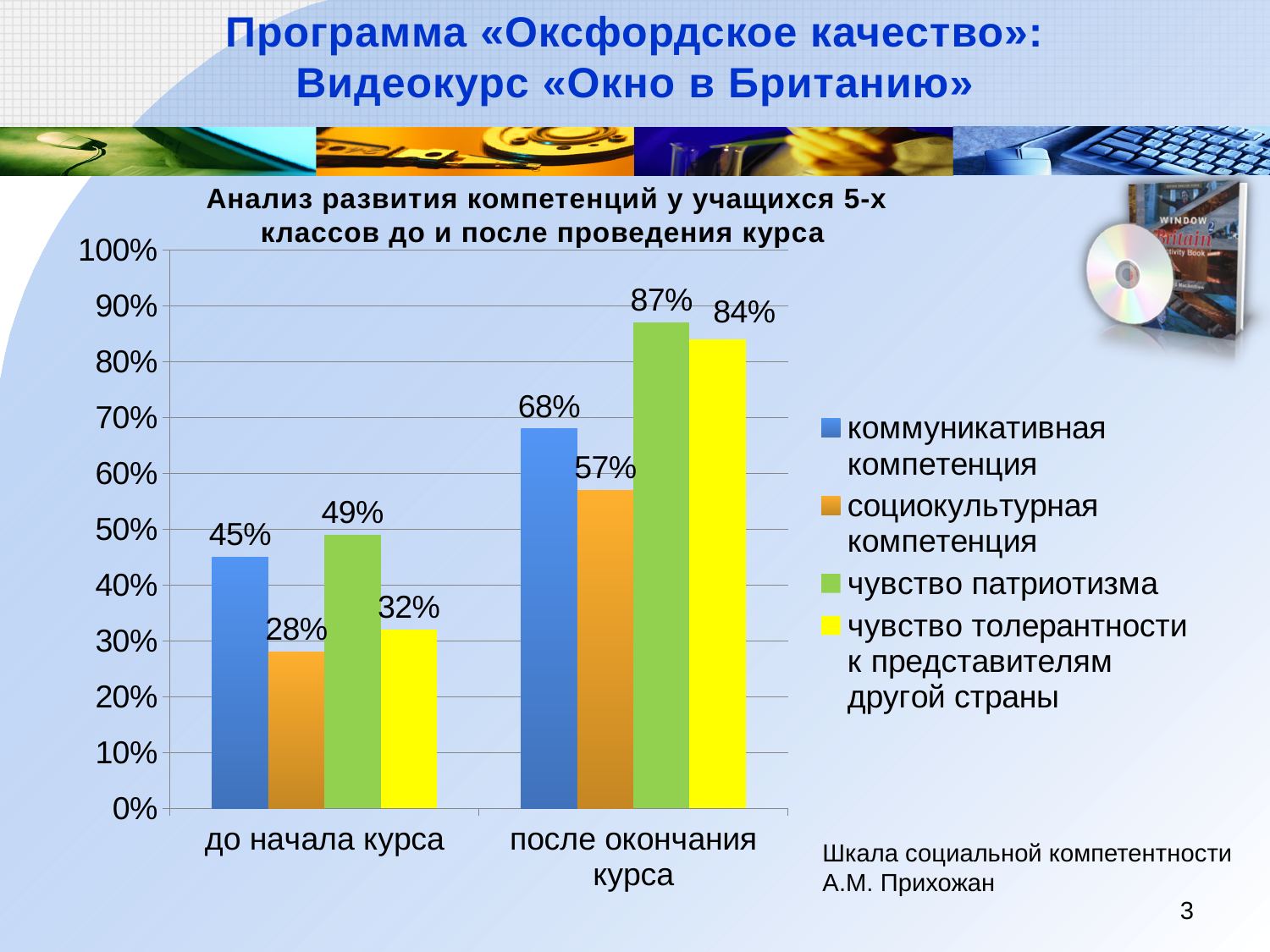
What is the difference between the values for «чувство патриотизма» after the course and before the course? 38% What kind of chart is shown on the slide? bar chart How many categories are shown on the x axis? 2 What is the value for «чувство патриотизма» in the category «после окончания курса»? 87% Which is larger: the value for «коммуникативная компетенция» or «социокультурная компетенция» in the category «после окончания курса»? коммуникативная компетенция How many series does the legend list? 4 Do the values for «чувство толерантности к представителям другой страны» rise or fall from «до начала курса» to «после окончания курса»? rise Which series has the highest value in the category «после окончания курса»? чувство патриотизма What is the value for «коммуникативная компетенция» in the category «до начала курса»? 45% What is the value for «чувство толерантности к представителям другой страны» in the category «после окончания курса»? 84% Which series has the lowest value in the category «до начала курса»? социокультурная компетенция What is the value for «социокультурная компетенция» in the category «до начала курса»? 28%